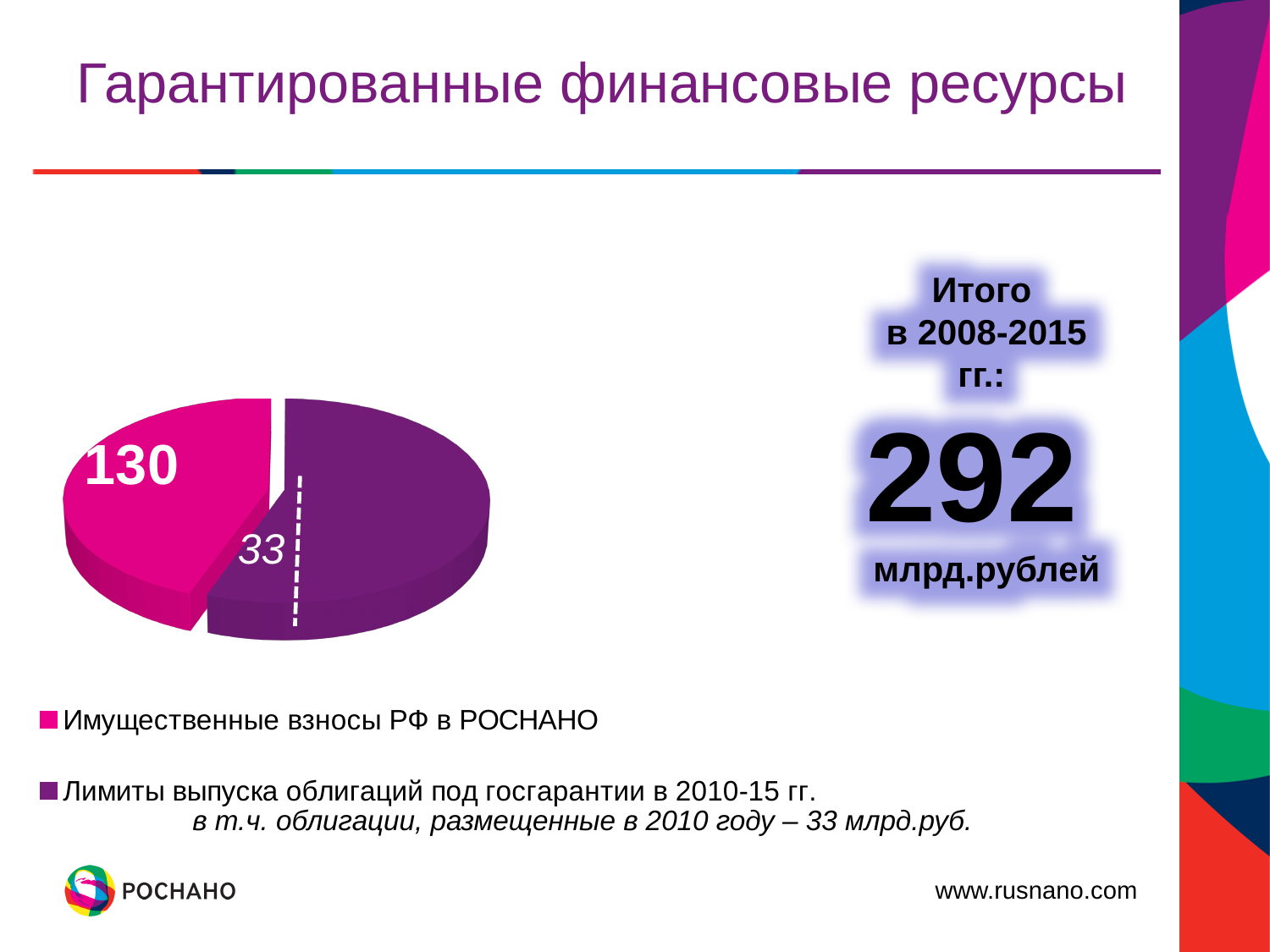
What value is printed for the bonds placed in 2010 (облигации, размещенные в 2010 году)? 33 млрд.руб. Which is larger: Имущественные взносы РФ в РОСНАНО or Лимиты выпуска облигаций под госгарантии в 2010-15 гг.? Лимиты выпуска облигаций под госгарантии в 2010-15 гг. Which slice of the pie chart is the smallest? Имущественные взносы РФ в РОСНАНО What kind of chart is shown on the slide? Pie chart What is the title of the slide containing the pie chart? Гарантированные финансовые ресурсы Which slice of the pie chart is the largest? Лимиты выпуска облигаций под госгарантии в 2010-15 гг. How many slices does the pie chart have? 2 What colour is the slice for Имущественные взносы РФ в РОСНАНО? Pink (magenta) What value is printed on the slice for Имущественные взносы РФ в РОСНАНО? 130 How many entries does the legend list? 2 What is the total of guaranteed financial resources for 2008-2015 shown on the slide? 292 млрд.рублей